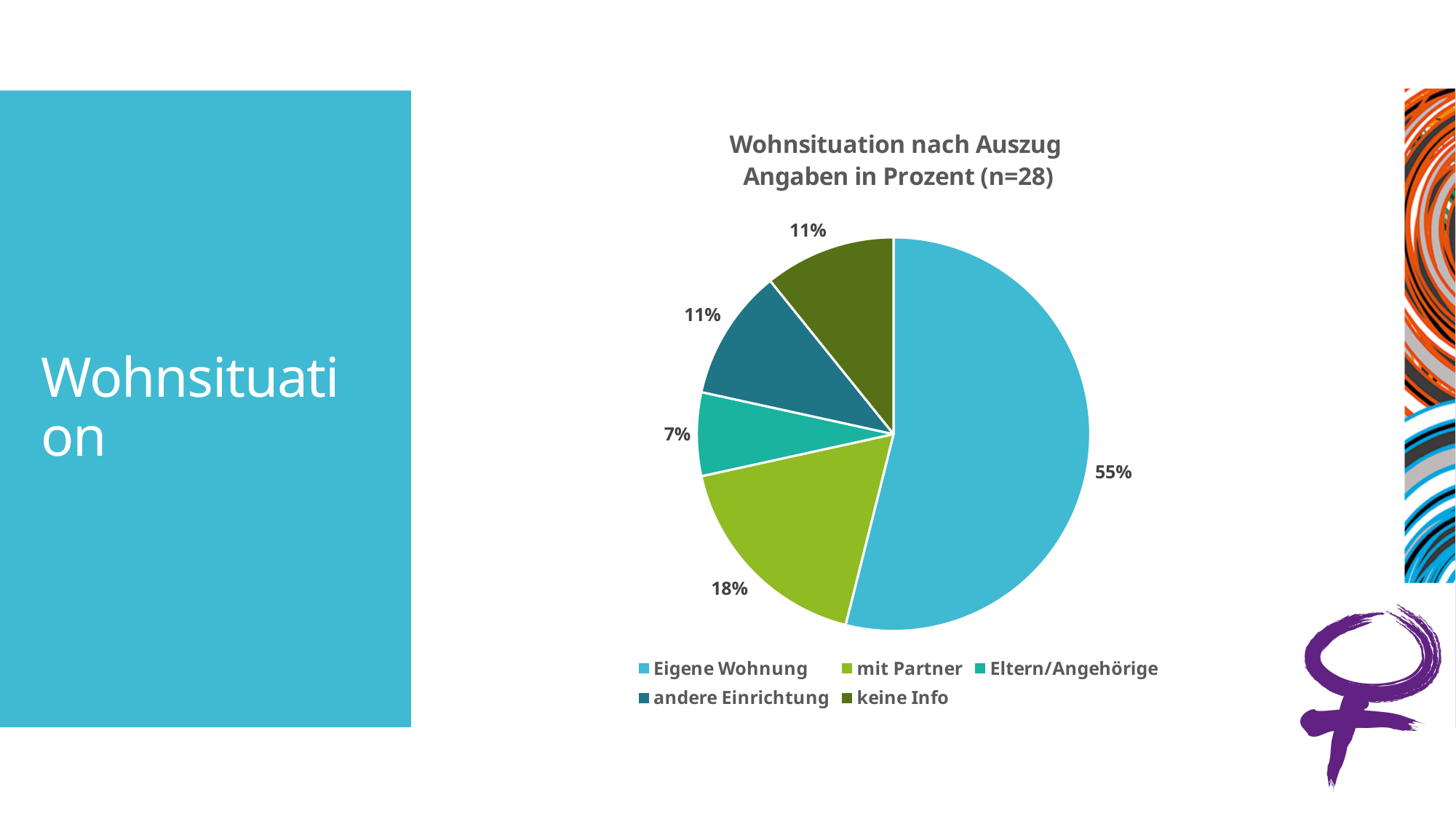
Which category has the largest slice of the pie? Eigene Wohnung What share of the pie does "keine Info" have? 11% What is the difference between the shares of "Eigene Wohnung" and "mit Partner"? 37% How many categories does the legend list? 5 What share of the pie does "Eigene Wohnung" have? 55% What kind of chart is shown on the slide? pie chart Which is larger, the share for "mit Partner" or the share for "andere Einrichtung"? mit Partner What share of the pie does "mit Partner" have? 18% What is the title of the chart? Wohnsituation nach Auszug Angaben in Prozent (n=28) Which category has the smallest slice of the pie? Eltern/Angehörige